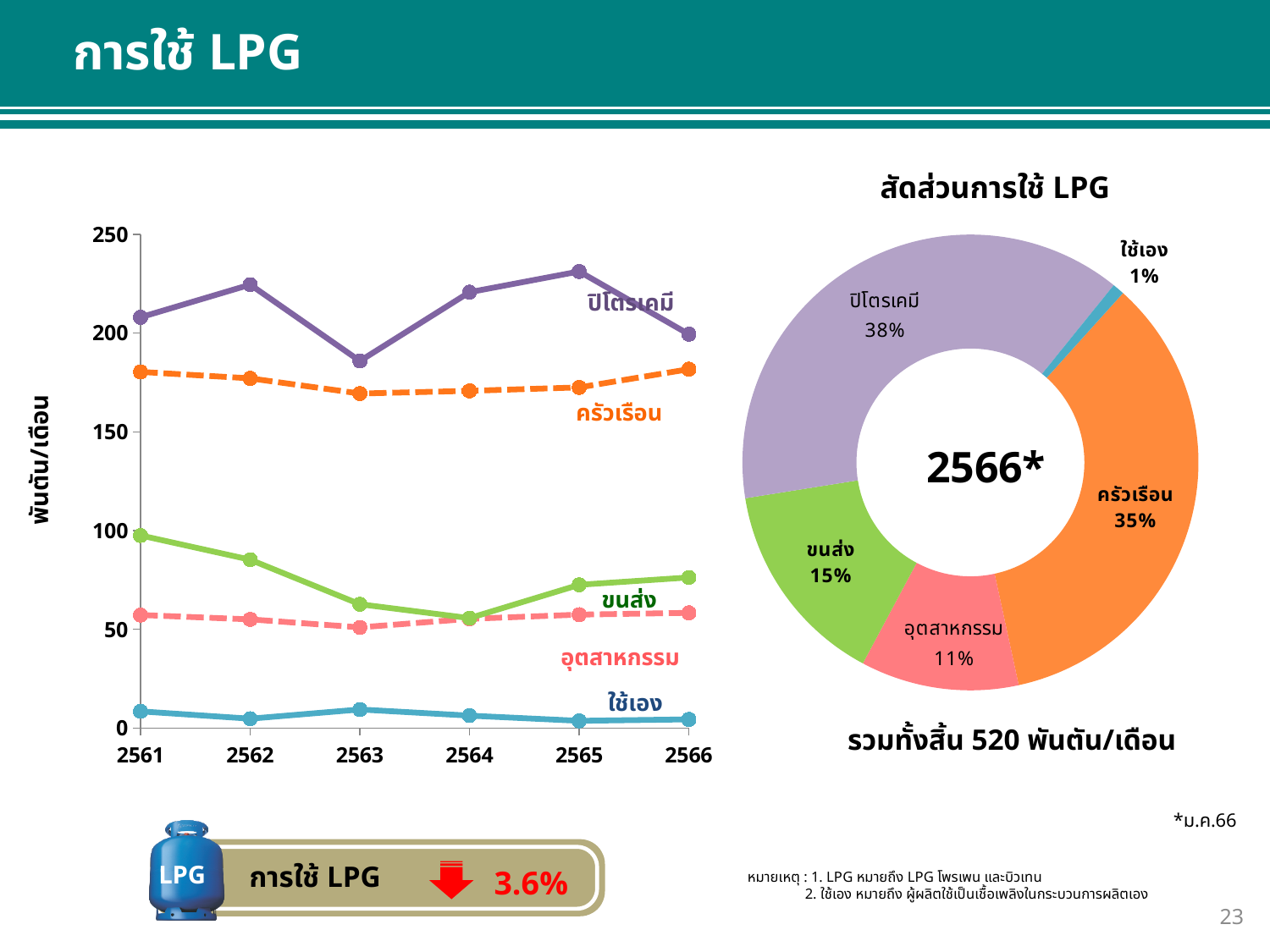
In the chart titled สัดส่วนการใช้ LPG, what is the difference in percentage points between ปิโตรเคมี and ครัวเรือน? 3 percentage points In the line chart on the left, how many series are plotted? 5 What kind of chart is the chart titled สัดส่วนการใช้ LPG? pie (donut) chart In the line chart on the left, which is larger in 2561: ขนส่ง or อุตสาหกรรม? ขนส่ง In the chart titled สัดส่วนการใช้ LPG, what share does ครัวเรือน have? 35% In the line chart on the left, is the value for ขนส่ง in 2564 greater or less than 100? less What kind of chart is the chart on the left of the slide? line chart In the line chart on the left, how many years are shown on the x axis? 6 In the line chart on the left, is the value for ปิโตรเคมี in 2565 greater or less than 200? greater In the line chart on the left, which series has the highest value in 2565? ปิโตรเคมี In the line chart on the left, which series has the lowest value in 2566? ใช้เอง In the line chart on the left, does the value for ปิโตรเคมี rise or fall from 2565 to 2566? fall